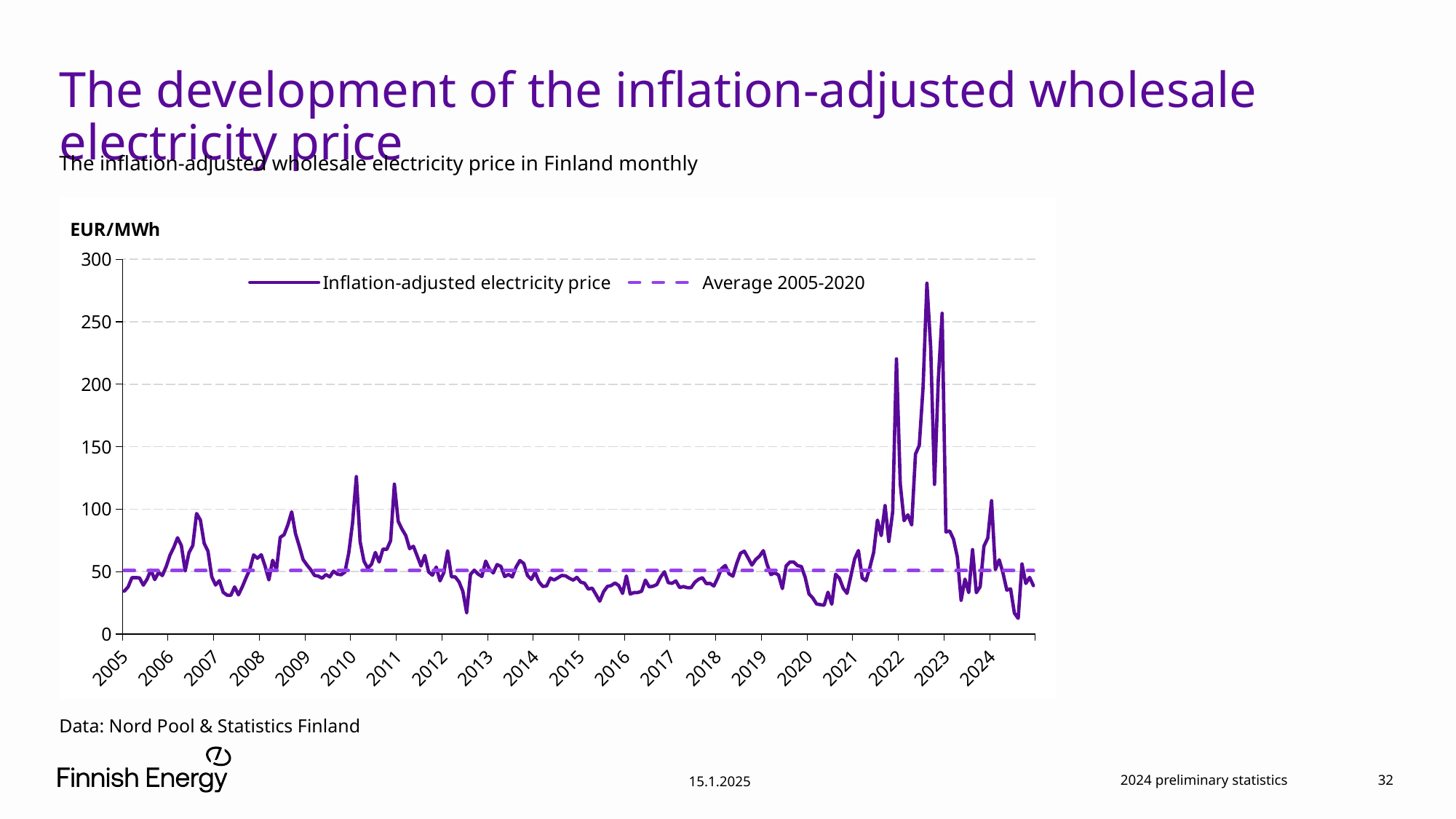
Does the inflation-adjusted electricity price rise or fall from its 2022 peak to the end of 2024? fall How many year labels are shown on the x axis? 20 Is the peak of the inflation-adjusted electricity price in 2010 greater or less than 100 EUR/MWh? greater Is the highest peak of the inflation-adjusted electricity price in 2022 greater or less than 250 EUR/MWh? greater Does the inflation-adjusted electricity price rise or fall from 2020 to 2022? rise What is the label of the dashed series in the legend? Average 2005-2020 What unit is shown on the y axis of the chart? EUR/MWh Is the inflation-adjusted electricity price at the start of 2005 greater or less than 50 EUR/MWh? less How many series does the legend list? 2 What kind of chart is shown on the slide? line chart In which year does the inflation-adjusted electricity price reach its highest peak? 2022